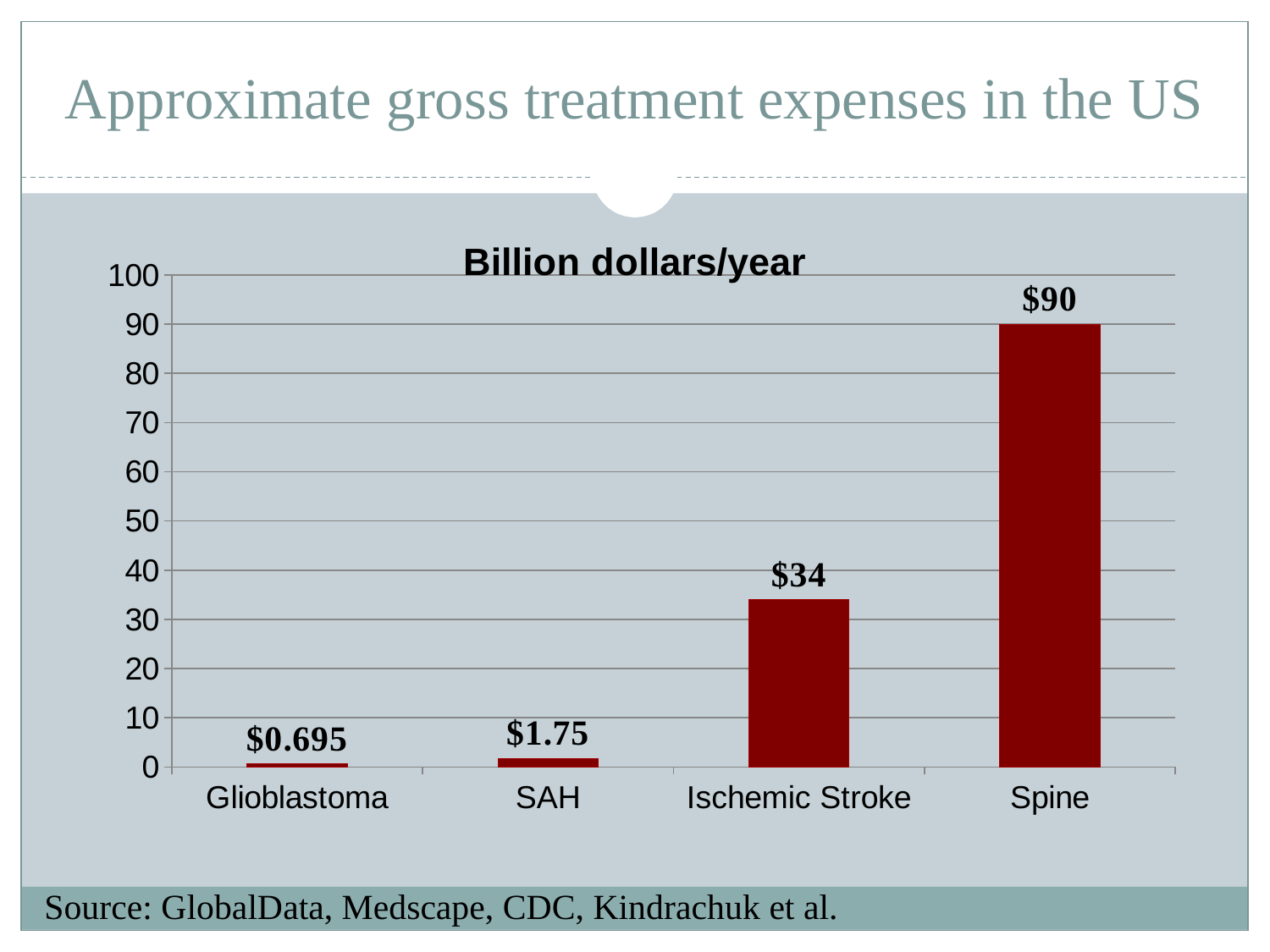
Is the value for Ischemic Stroke greater or less than 40? less What kind of chart is shown on the slide? bar chart How many categories are shown on the x axis? 4 What is the value for Ischemic Stroke? $34 What is the difference between the values for Spine and Ischemic Stroke? $56 What is the value for Spine? $90 Which category has the lowest value? Glioblastoma What is the value for SAH? $1.75 What is the value for Glioblastoma? $0.695 Which category has the highest value? Spine What is the title of the chart? Billion dollars/year Which is larger, the value for SAH or the value for Ischemic Stroke? Ischemic Stroke